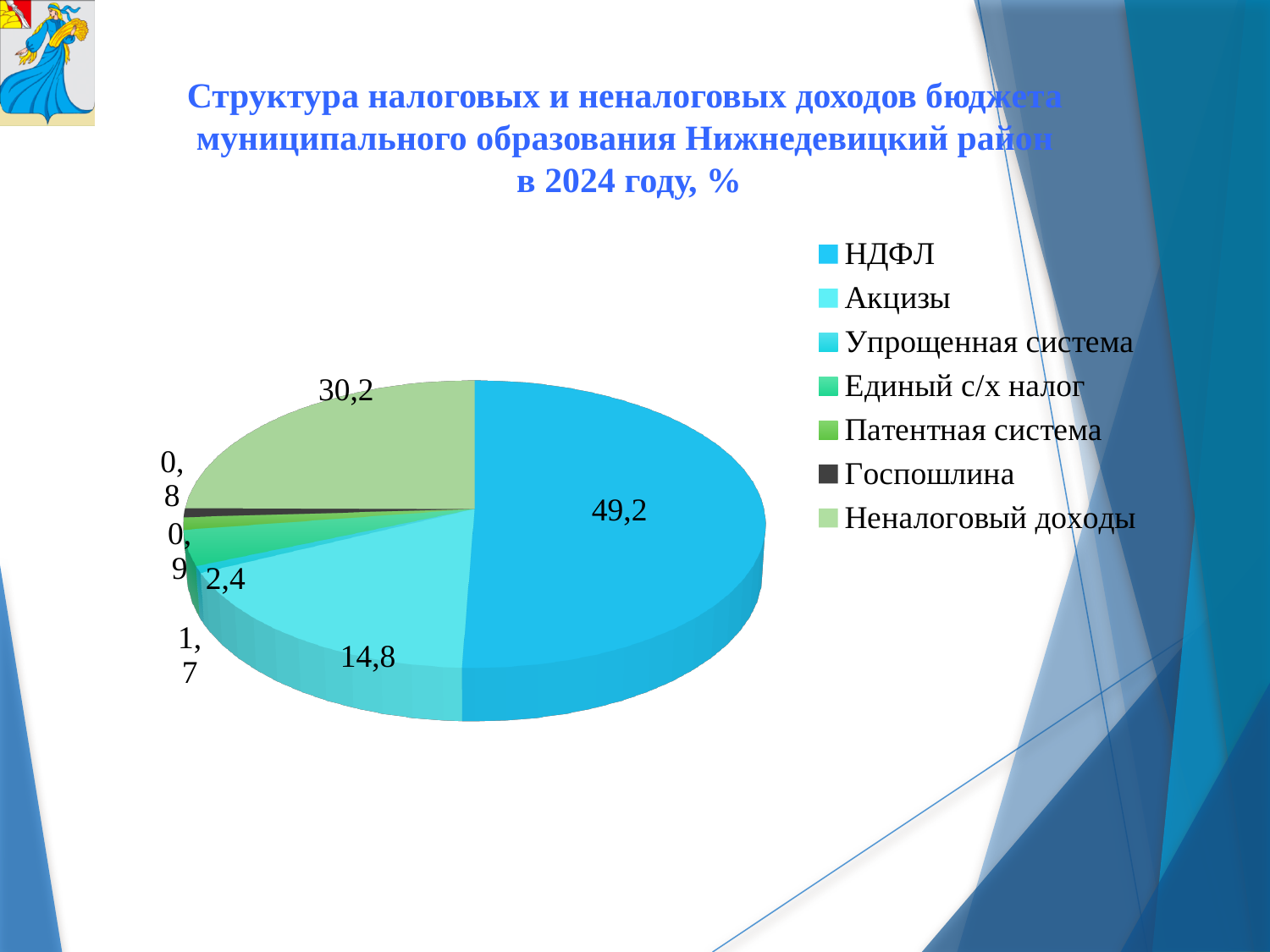
Which category has the smallest share of the pie? Госпошлина What is the value for Акцизы? 14,8 What year does the chart title refer to? 2024 How many slices does the pie chart have? 7 How many entries does the legend list? 7 What is the value for Упрощенная система? 2,4 What kind of chart is shown on the slide? Pie chart Which is larger, the value for Акцизы or the value for Неналоговый доходы? Неналоговый доходы What is the value for Неналоговый доходы? 30,2 What is the value for НДФЛ? 49,2 What is the difference between the values for НДФЛ and Неналоговый доходы? 19 Which category has the largest share of the pie? НДФЛ